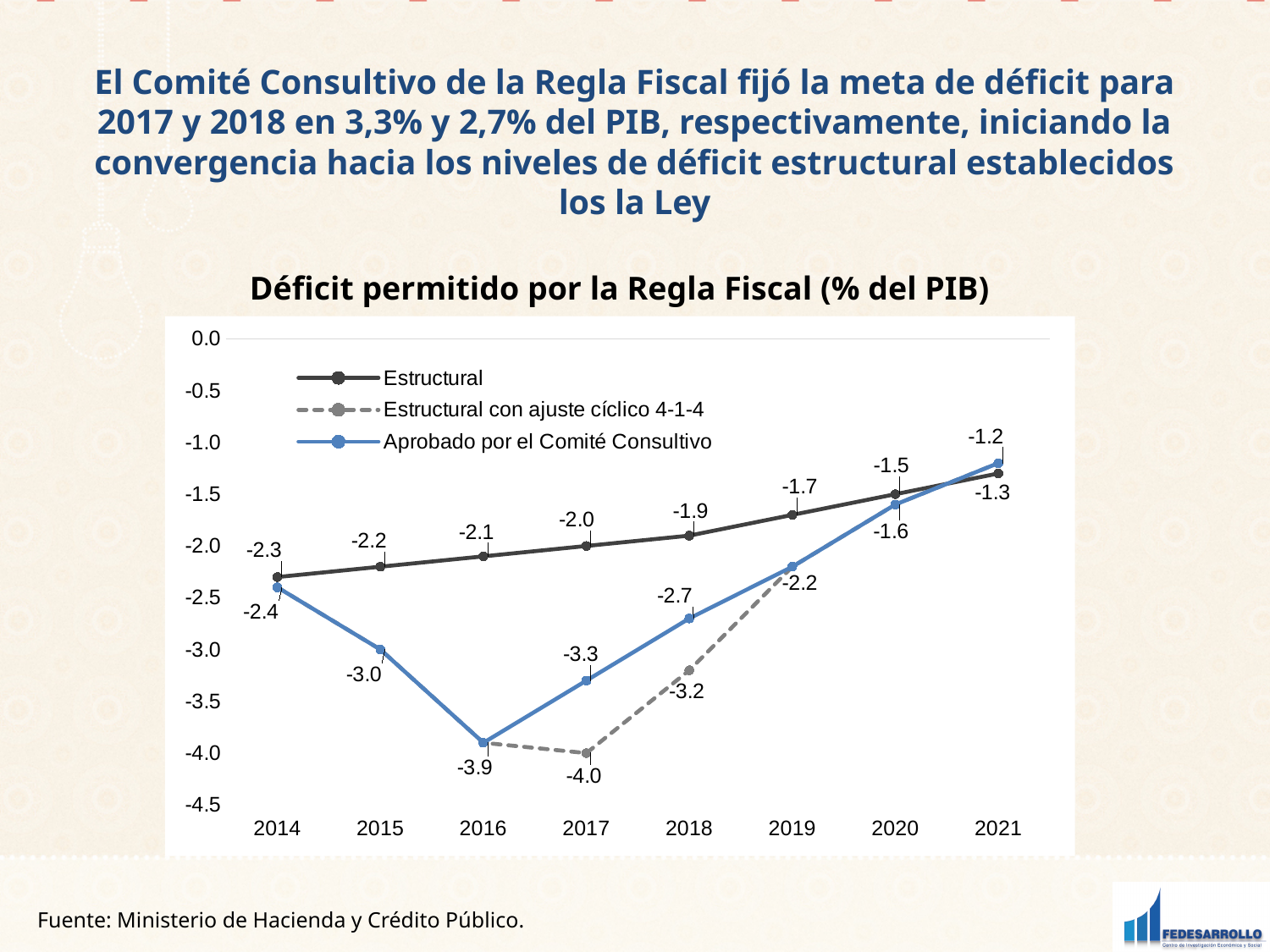
What is the value of the Aprobado por el Comité Consultivo series in 2016? -3.9 What is the value of the Estructural con ajuste cíclico 4-1-4 series in 2017? -4.0 What is the value of the Aprobado por el Comité Consultivo series in 2021? -1.2 In which year does the Aprobado por el Comité Consultivo series reach its lowest value? 2016 In 2018, which series has the higher value: Estructural or Aprobado por el Comité Consultivo? Estructural Does the Estructural series rise or fall from 2014 to 2021? Rise What kind of chart is shown on the slide? Line chart What is the title of the chart? Déficit permitido por la Regla Fiscal (% del PIB) What is the value of the Estructural series in 2017? -2.0 How many years are shown on the x axis? 8 What is the difference between the Estructural value in 2021 and its value in 2014? 1.0 How many series does the legend list? 3